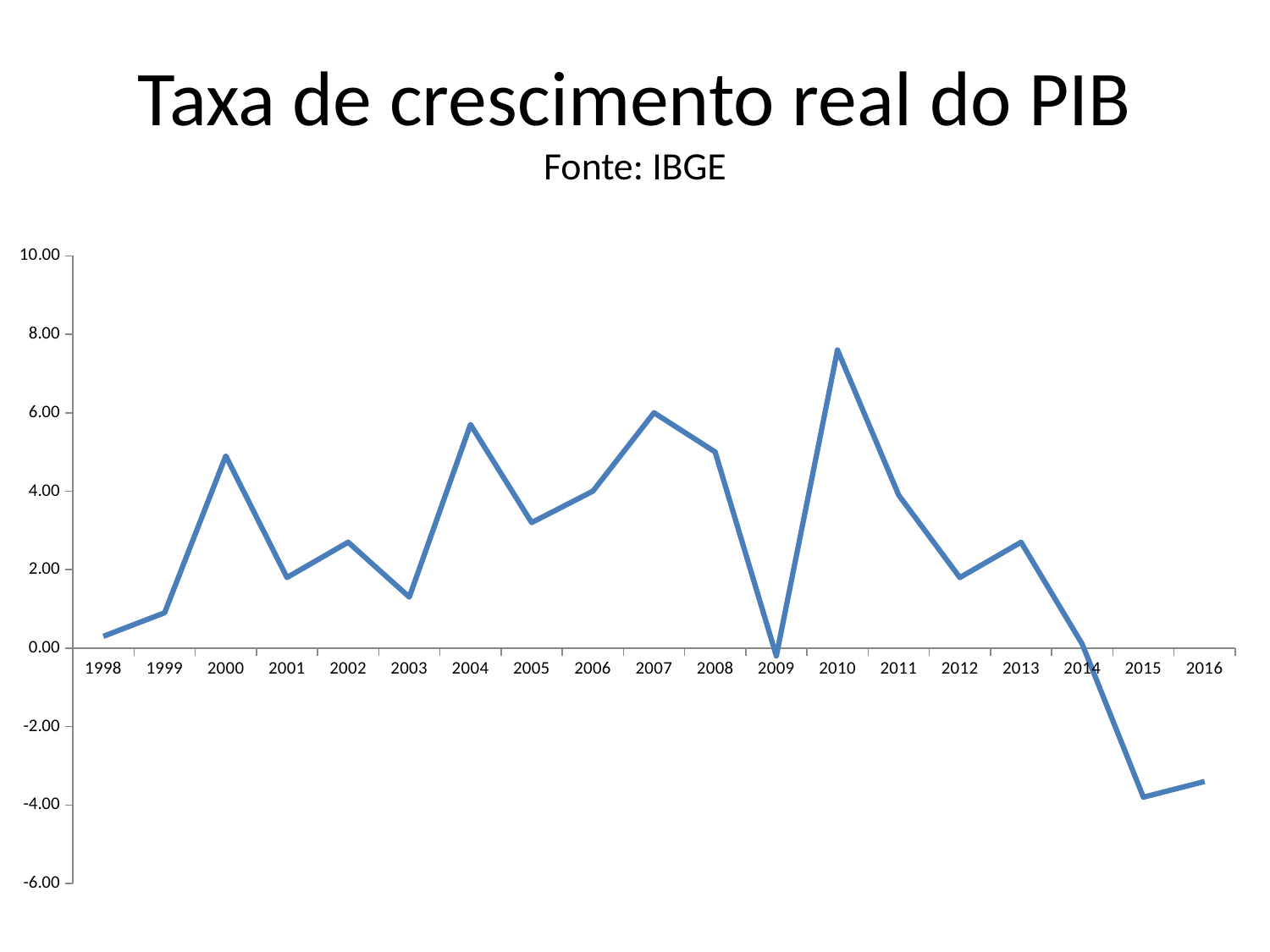
Is the value for 2010 greater or less than 6.00? greater Which year has the highest real GDP growth rate in the chart? 2010 How many years are plotted on the x axis? 19 What kind of chart is shown on the slide? line chart Is the value for 2004 greater or less than 4.00? greater Is the value for 2003 greater or less than 2.00? less Which year has the larger value, 2004 or 2005? 2004 Which year has the larger value, 2010 or 2007? 2010 Which year has the lowest real GDP growth rate in the chart? 2015 Do the values rise or fall from 2013 to 2015? fall